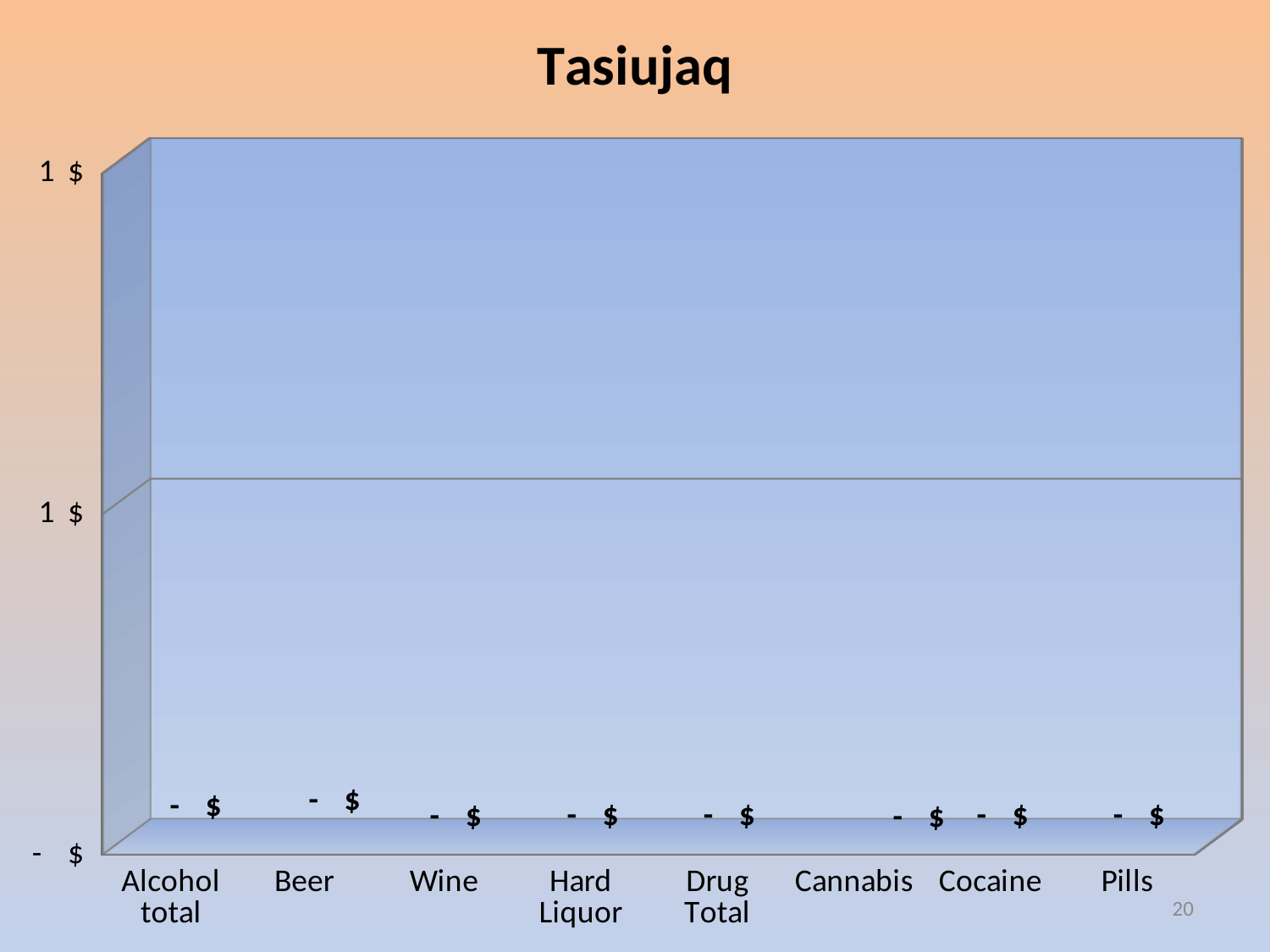
Which category appears first on the x axis? Alcohol total What data label is shown for Alcohol total? - $ What is the title of the chart? Tasiujaq What data label is shown for Cannabis? - $ What data label is shown for Drug Total? - $ Is the value for Wine greater or less than 1 $? less How many categories are shown on the x axis of the chart? 8 What data label is shown for Beer? - $ What data label is shown for Pills? - $ Is the value for Cocaine greater or less than 1 $? less What kind of chart is shown on the slide? bar chart